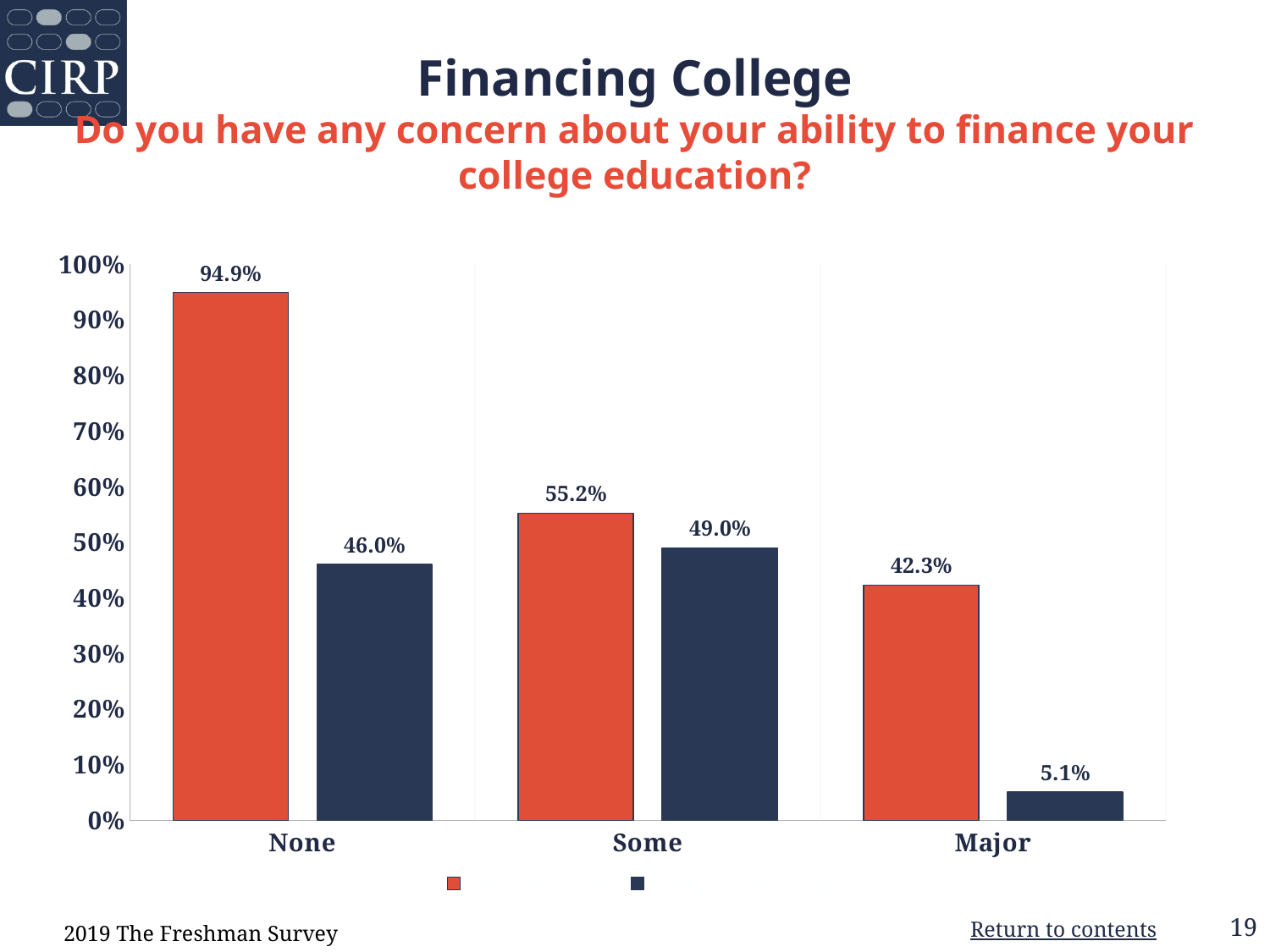
What is the difference between the orange and dark blue bars for Major? 37.2% What is the value of the dark blue bar for None? 46.0% What kind of chart is shown on the slide? bar chart What is the value of the dark blue bar for Major? 5.1% Which category has the highest orange bar? None What is the value of the orange bar for None? 94.9% How many series does the legend show? 2 How many categories are shown on the x axis? 3 What is the value of the orange bar for Some? 55.2% Which category has the lowest dark blue bar? Major For Some, which bar is larger, the orange or the dark blue? orange Do the orange bars rise or fall from None to Major? fall